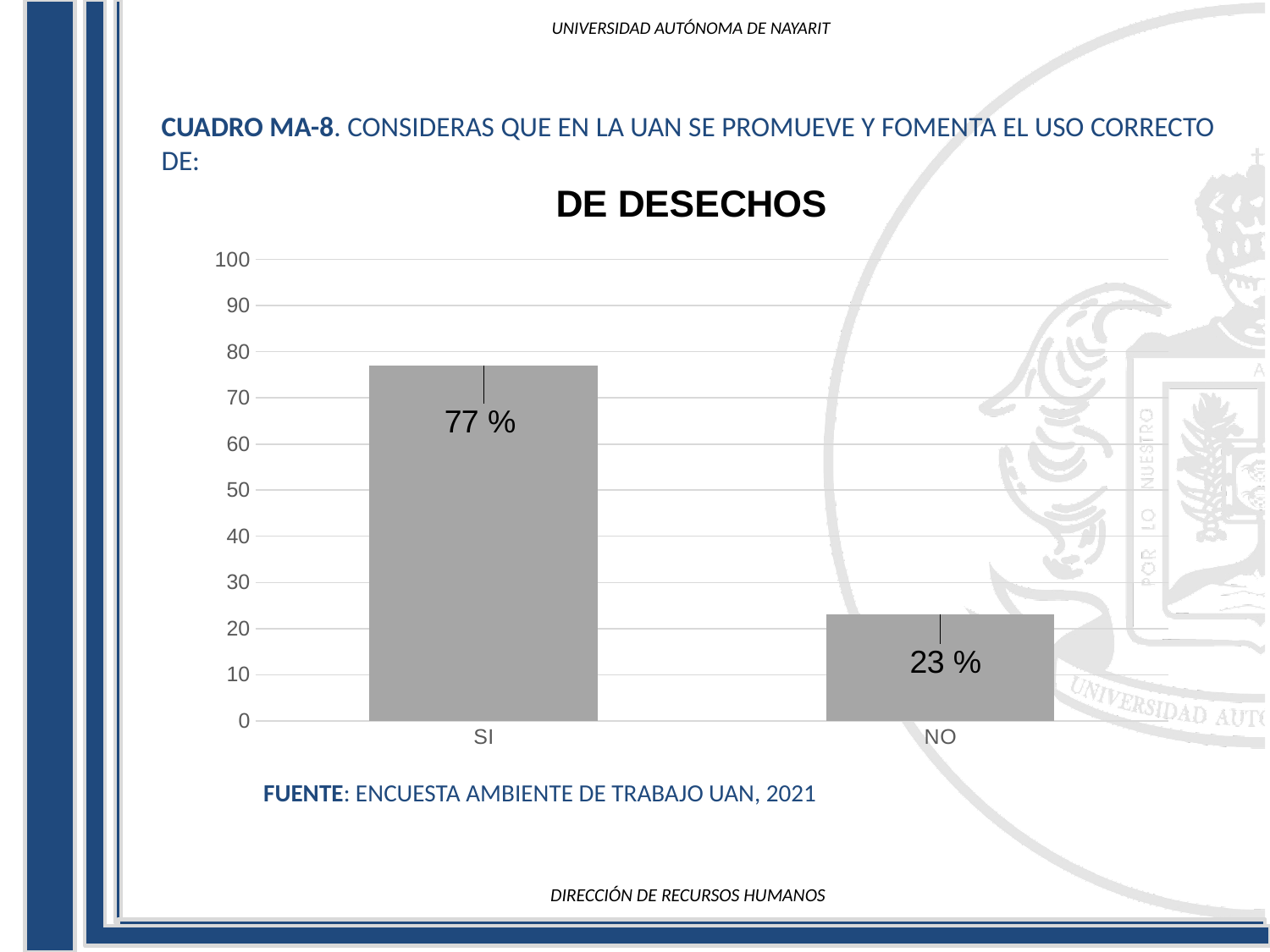
What is the difference between the values for SI and NO? 54 % Which is larger, the value for SI or the value for NO? SI What is the title of the chart? DE DESECHOS Which category has the lowest value? NO What is the value for SI? 77 % Which category has the highest value? SI What is the highest value shown on the y axis? 100 Is the value for NO greater or less than 30? less How many categories are shown on the x axis? 2 Is the value for SI greater or less than 70? greater What kind of chart is shown? bar chart What is the value for NO? 23 %